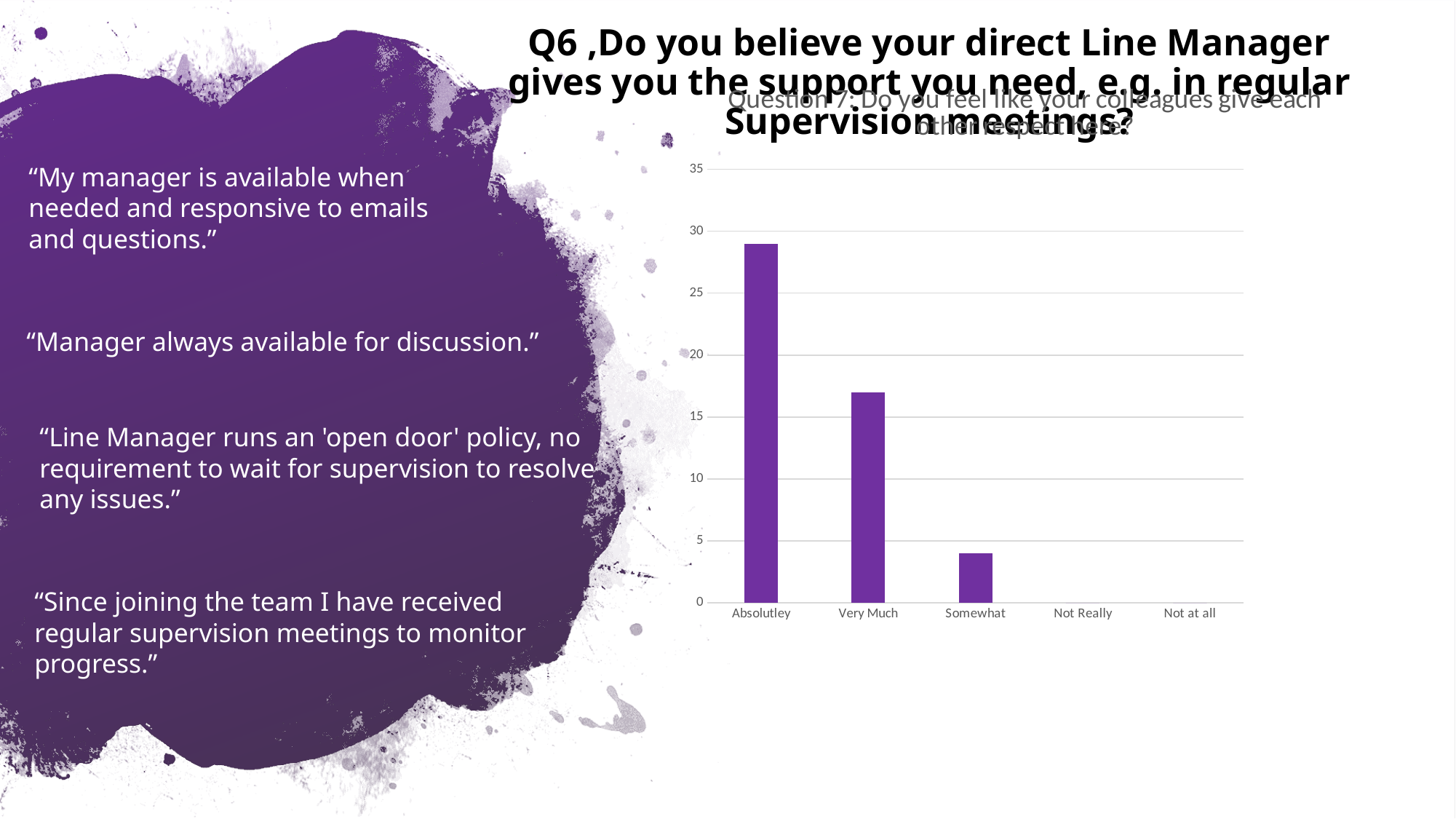
What kind of chart is shown on the slide? bar chart Is the value for Somewhat greater or less than 5? less Which is larger, the value for Absolutley or the value for Very Much? Absolutley Is the value for Absolutley greater or less than 30? less Is the value for Absolutley greater or less than 25? greater Do the values rise or fall moving from Absolutley to Not at all along the x axis? fall Which category has the highest value in the chart? Absolutley Which is larger, the value for Very Much or the value for Somewhat? Very Much How many categories are shown on the x axis of the chart? 5 What colour are the bars in the chart? purple